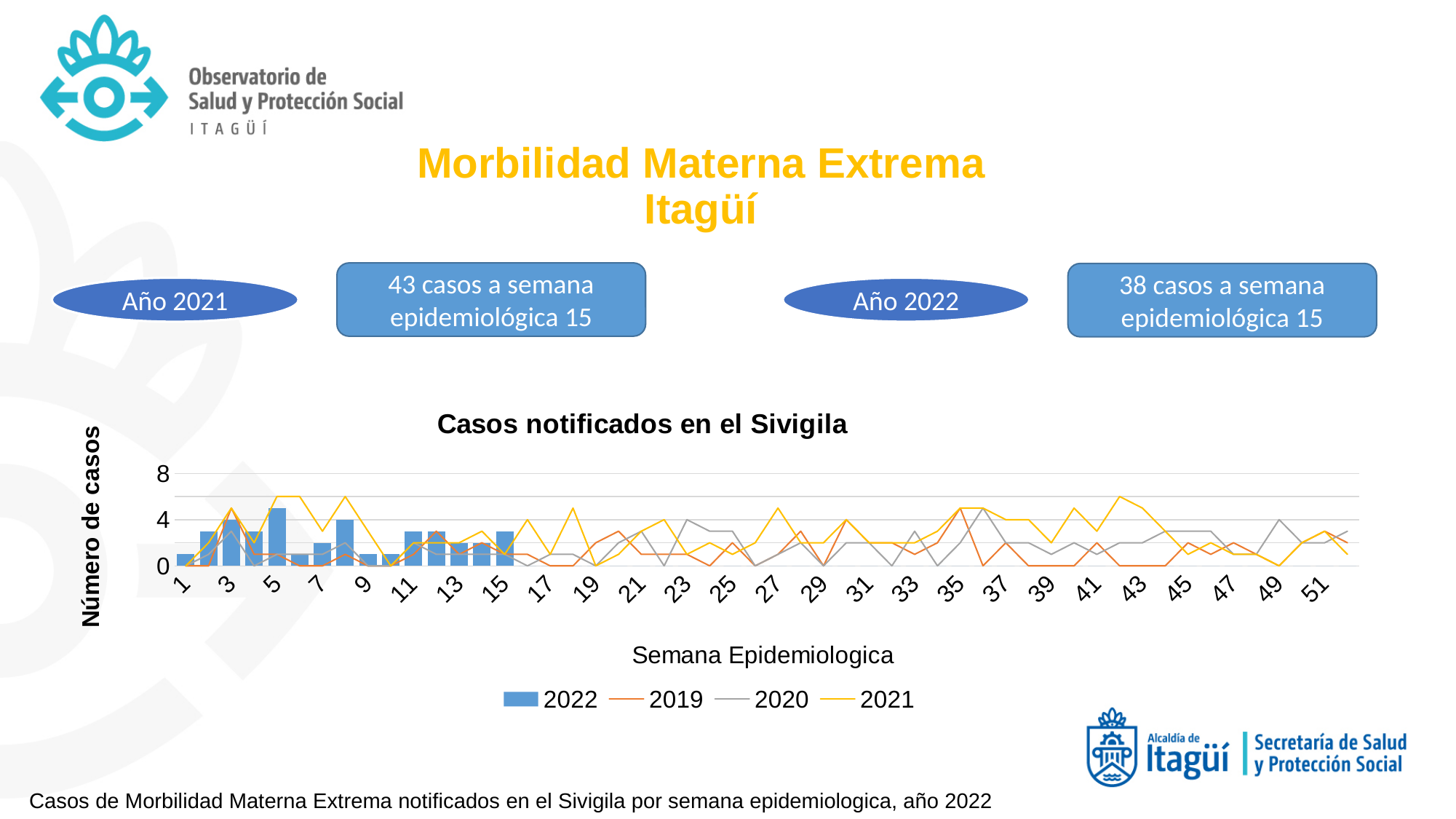
Is the 2022 value for week 9 greater or less than 4? less What kind of chart is shown on the slide? Combined bar and line chart What is the title of the chart on the slide? Casos notificados en el Sivigila Which series in the chart is drawn as bars rather than a line? 2022 Which is larger for 2022: the value for week 3 or the value for week 7? week 3 Which is larger for 2022: the value for week 5 or the value for week 1? week 5 Is the 2021 value for week 5 greater or less than 4? greater Is the 2022 value for week 1 greater or less than 4? less How many series does the chart legend list? 4 In which epidemiological week is the 2022 bar the highest? 5 Up to which epidemiological week are 2022 bars plotted in the chart? 15